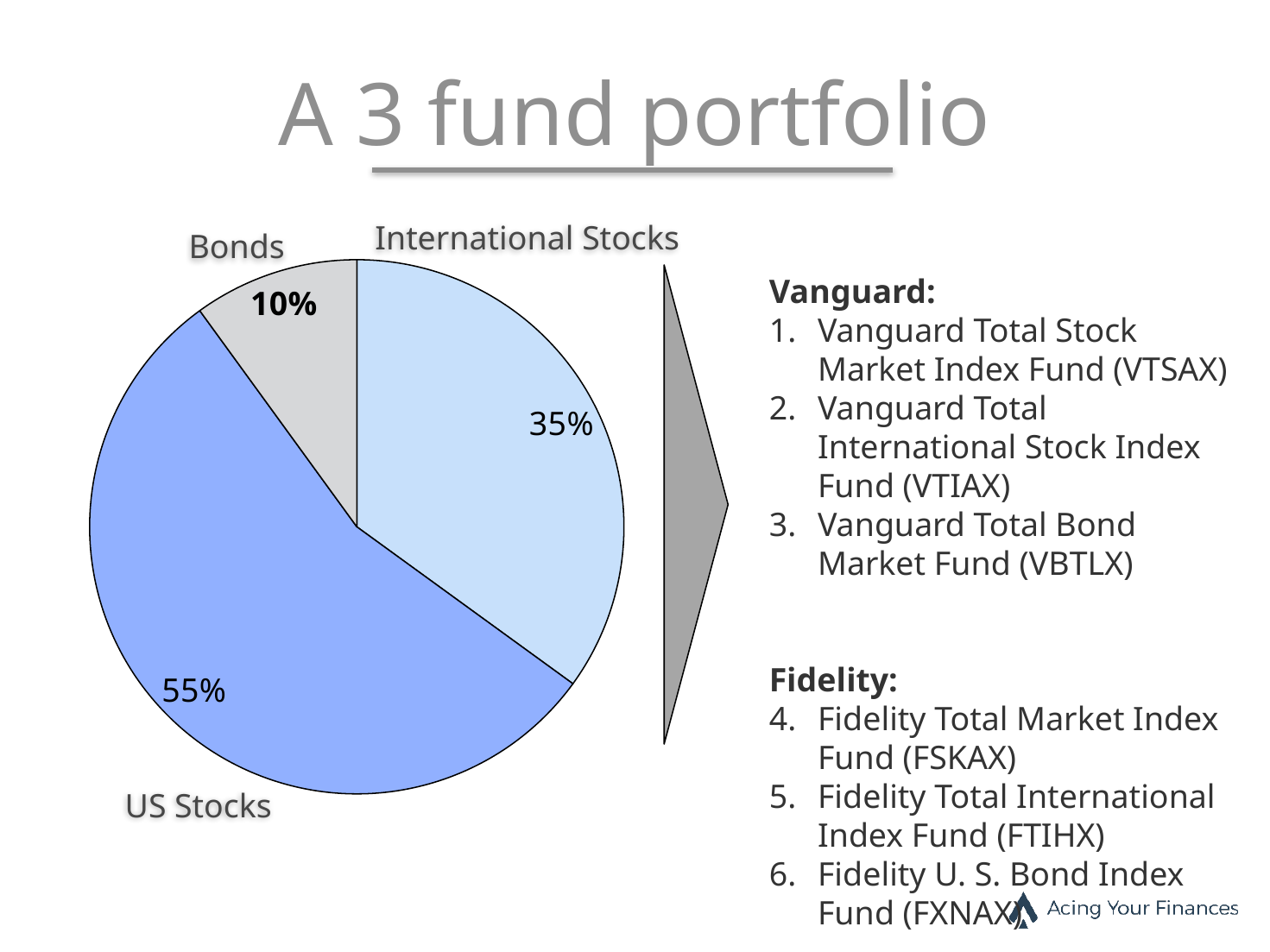
What share of the portfolio is allocated to US Stocks? 55% What is the combined share of US Stocks and International Stocks? 90% How many slices does the pie chart have? 3 What is the title of the slide containing the pie chart? A 3 fund portfolio What is the difference in percentage points between US Stocks and International Stocks? 20 What is the difference in percentage points between International Stocks and Bonds? 25 What share of the portfolio is allocated to Bonds? 10% What kind of chart is shown on the slide? pie chart Which is larger, the share for International Stocks or the share for Bonds? International Stocks What share of the portfolio is allocated to International Stocks? 35% Which category has the smallest slice of the pie? Bonds Which category has the largest slice of the pie? US Stocks